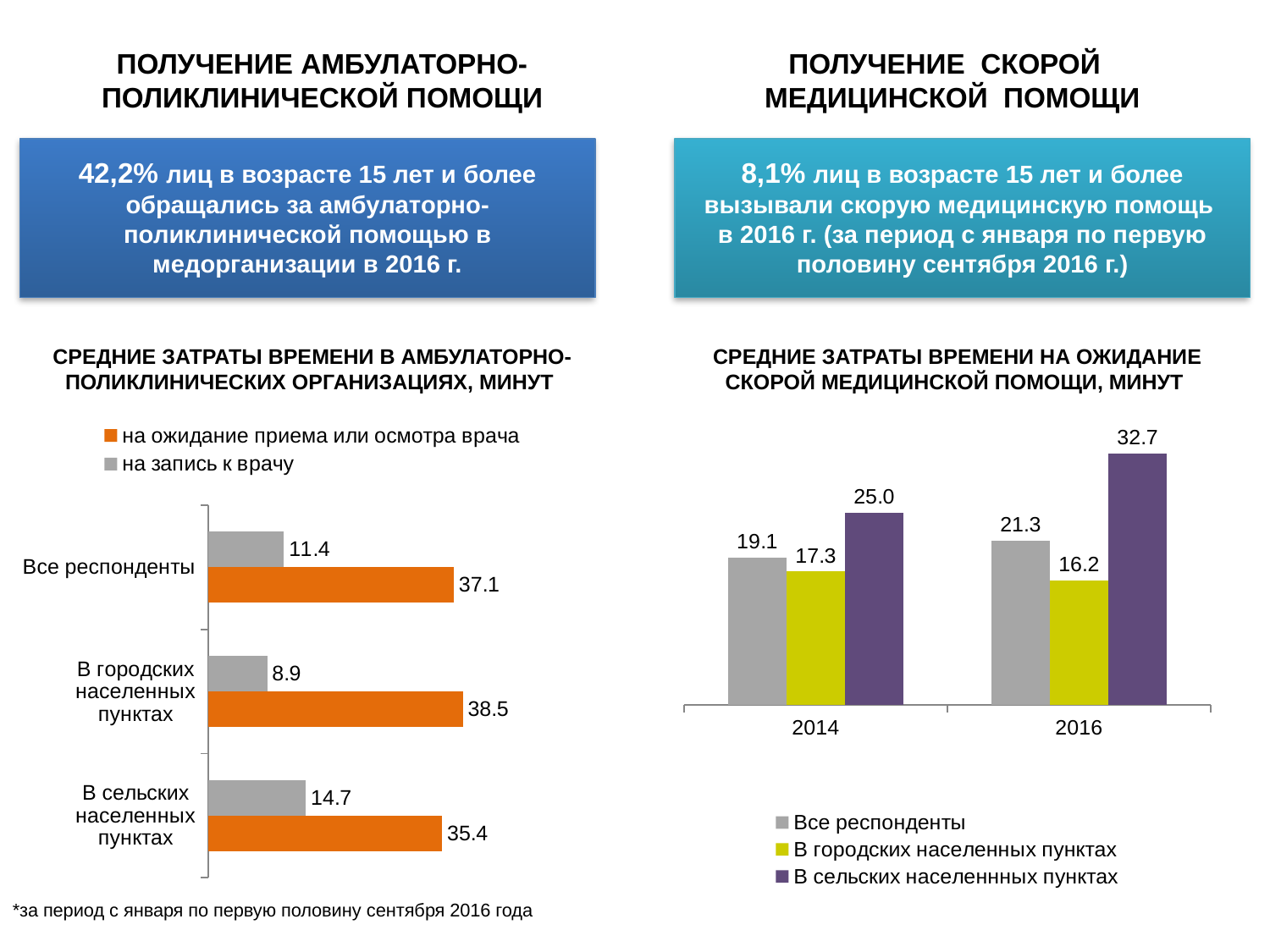
In the right chart (average waiting time for emergency medical care, minutes), what is the difference between 'В сельских населеннных пунктах' in 2016 and in 2014? 7.7 In the left chart (average time spent in outpatient clinics, minutes), what is the difference between 'на ожидание приема или осмотра врача' and 'на запись к врачу' for 'Все респонденты'? 25.7 In the left chart (average time spent in outpatient clinics, minutes), what is the value for 'на ожидание приема или осмотра врача' for 'Все респонденты'? 37.1 In the left chart (average time spent in outpatient clinics, minutes), how many series does the legend list? 2 In the left chart (average time spent in outpatient clinics, minutes), which category has the lowest value for 'на запись к врачу'? В городских населенных пунктах In the left chart (average time spent in outpatient clinics, minutes), which category has the highest value for 'на ожидание приема или осмотра врача'? В городских населенных пунктах In the right chart (average waiting time for emergency medical care, minutes), which is larger: 'Все респонденты' in 2014 or 'Все респонденты' in 2016? 2016 In the right chart (average waiting time for emergency medical care, minutes), how many series does the legend list? 3 In the left chart (average time spent in outpatient clinics, minutes), what is the value for 'на запись к врачу' for 'В сельских населенных пунктах'? 14.7 In the right chart (average waiting time for emergency medical care, minutes), what is the value for 'В городских населенных пунктах' in 2014? 17.3 In the right chart (average waiting time for emergency medical care, minutes), what is the value for 'В сельских населеннных пунктах' in 2016? 32.7 What kind of chart is the left chart (average time spent in outpatient clinics, minutes)? Bar chart